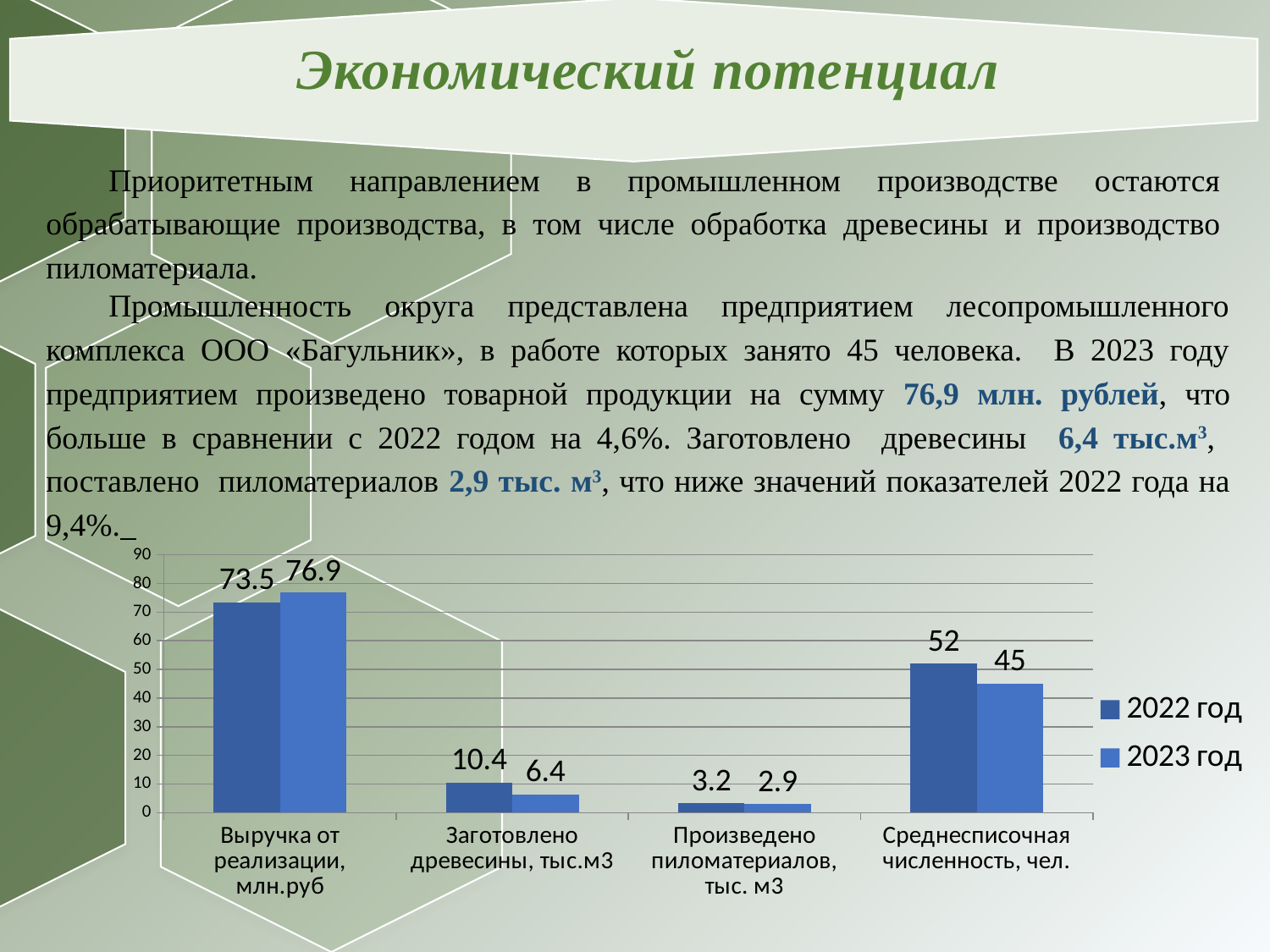
What is the value for 2022 год in the category Выручка от реализации, млн.руб? 73.5 How many categories are shown on the x axis of the chart? 4 What is the difference between the 2022 год and 2023 год values for Среднесписочная численность, чел.? 7 What is the difference between the 2022 год and 2023 год values for Заготовлено древесины, тыс.м3? 4 What is the maximum value shown on the vertical axis of the chart? 90 What kind of chart is shown on the slide? bar chart What is the value for 2023 год in the category Заготовлено древесины, тыс.м3? 6.4 Which is larger for Выручка от реализации, млн.руб: the 2022 год value or the 2023 год value? 2023 год How many series does the legend list? 2 What is the value for 2023 год in the category Среднесписочная численность, чел.? 45 Which category has the lowest value for 2022 год? Произведено пиломатериалов, тыс. м3 Which category has the highest value for 2023 год? Выручка от реализации, млн.руб